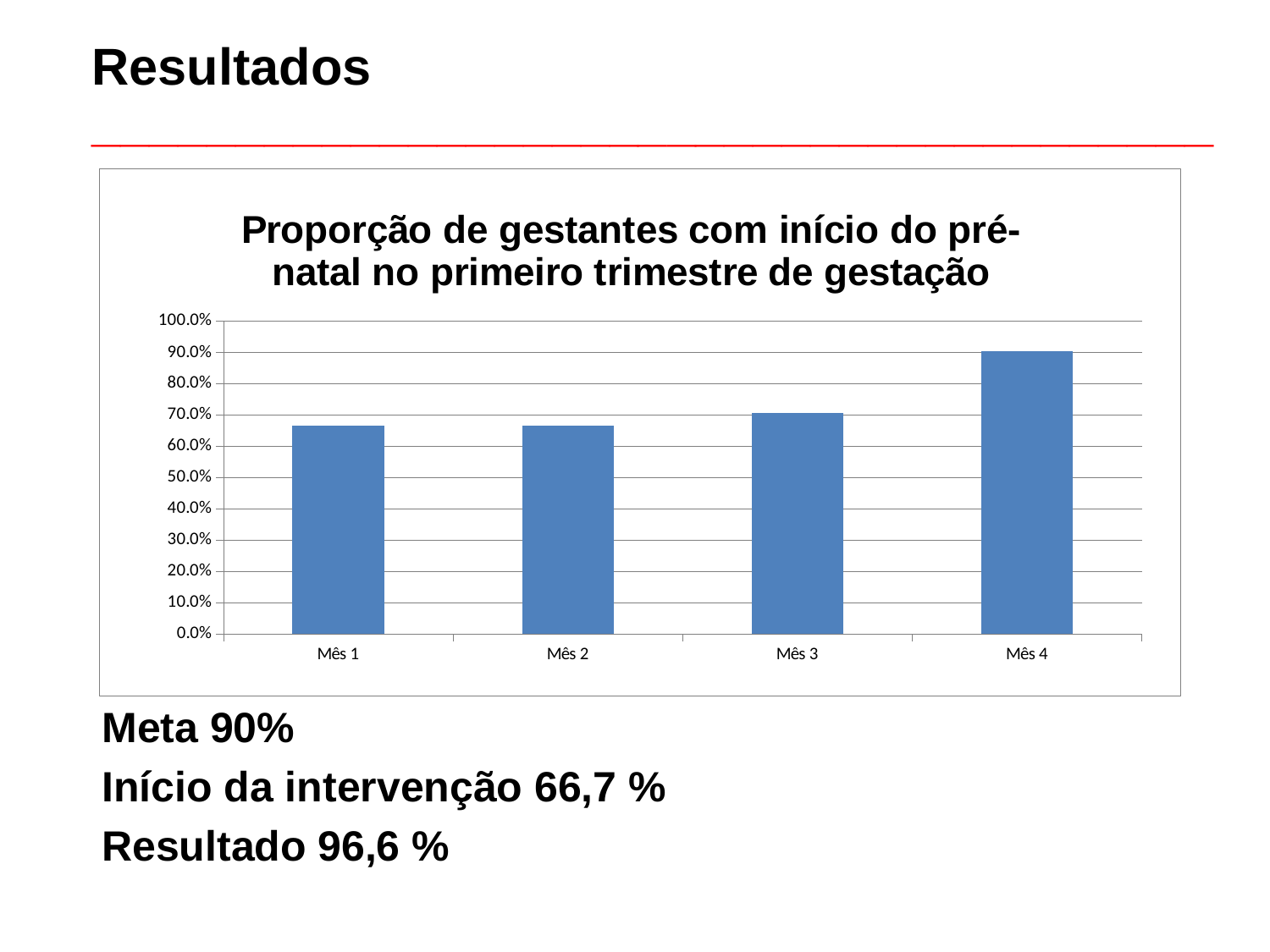
What is the title of the chart? Proporção de gestantes com início do pré-natal no primeiro trimestre de gestação Which month has the highest proportion? Mês 4 What kind of chart is shown on the slide? bar chart Is the value for Mês 3 greater or less than 80%? less Is the value for Mês 4 greater or less than 80%? greater Is the value for Mês 1 greater or less than 70%? less Which is larger, the value for Mês 3 or the value for Mês 2? Mês 3 What is the maximum value shown on the y axis? 100.0% Which is larger, the value for Mês 4 or the value for Mês 1? Mês 4 How many months (categories) are plotted on the x axis? 4 Do the values generally rise or fall from Mês 1 to Mês 4? rise